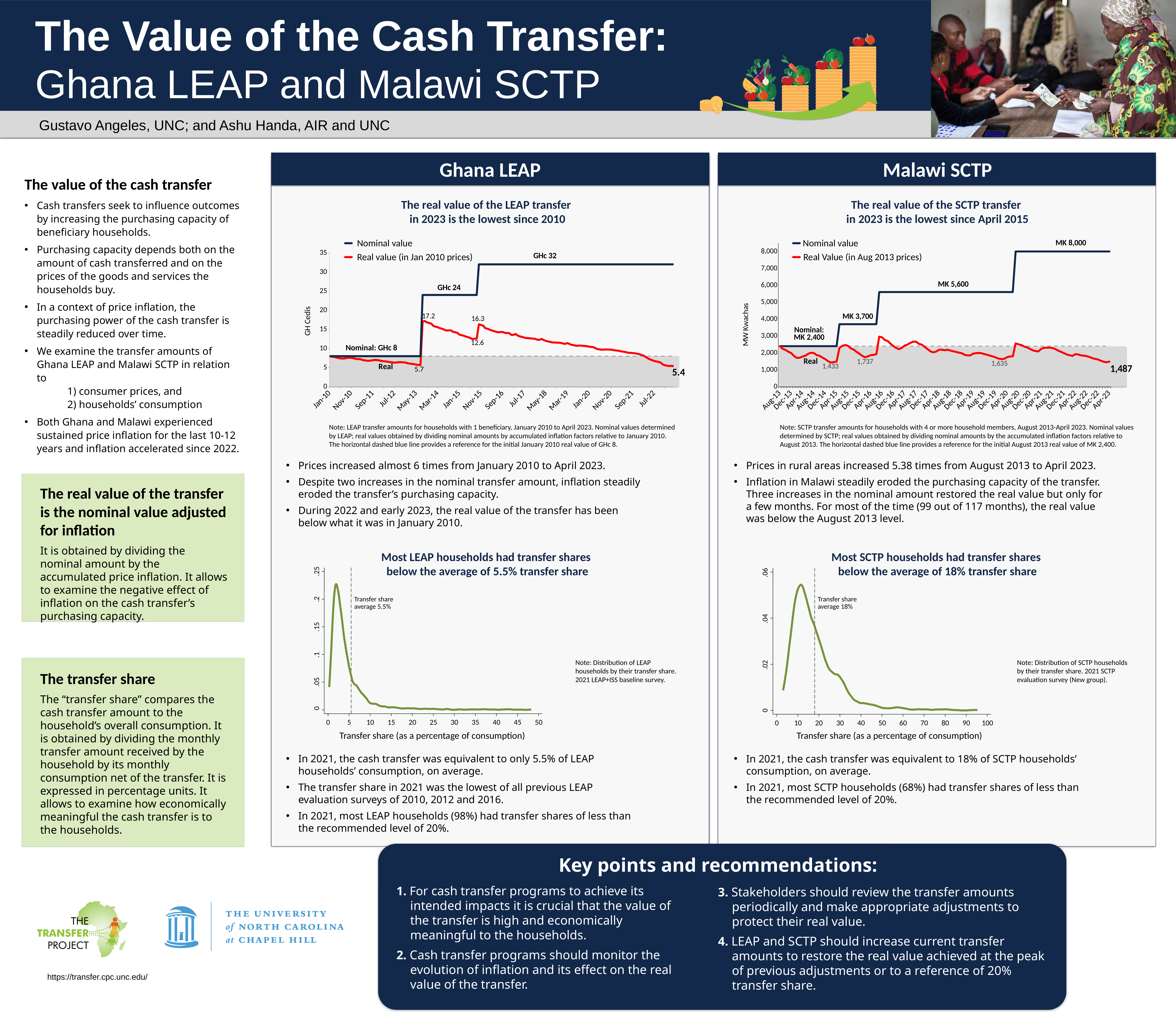
In the Ghana LEAP real value chart, which labelled real-value peak is larger, 17.2 or 16.3? 17.2 What kind of chart is the Malawi SCTP real value chart? Line chart In the SCTP transfer share distribution chart, what is the transfer share average marked by the dashed line? 18% In the Malawi SCTP real value chart, what is the real value labelled at the end of the series in 2023? 1,487 In the LEAP transfer share distribution chart, what is the transfer share average marked by the dashed line? 5.5% In the Malawi SCTP real value chart, what is the difference between the nominal values MK 5,600 and MK 3,700? MK 1,900 In the Malawi SCTP real value chart, what is the initial nominal transfer value? MK 2,400 How many series does the legend of the Ghana LEAP real value chart list? 2 In the Ghana LEAP real value chart, what is the final nominal transfer value shown? GHc 32 In the Ghana LEAP real value chart, what is the difference between the nominal values GHc 32 and GHc 24? GHc 8 In the Ghana LEAP real value chart, what is the real value of the transfer labelled at the end of the series in 2023? 5.4 In the Malawi SCTP real value chart, what is the highest nominal transfer value shown? MK 8,000